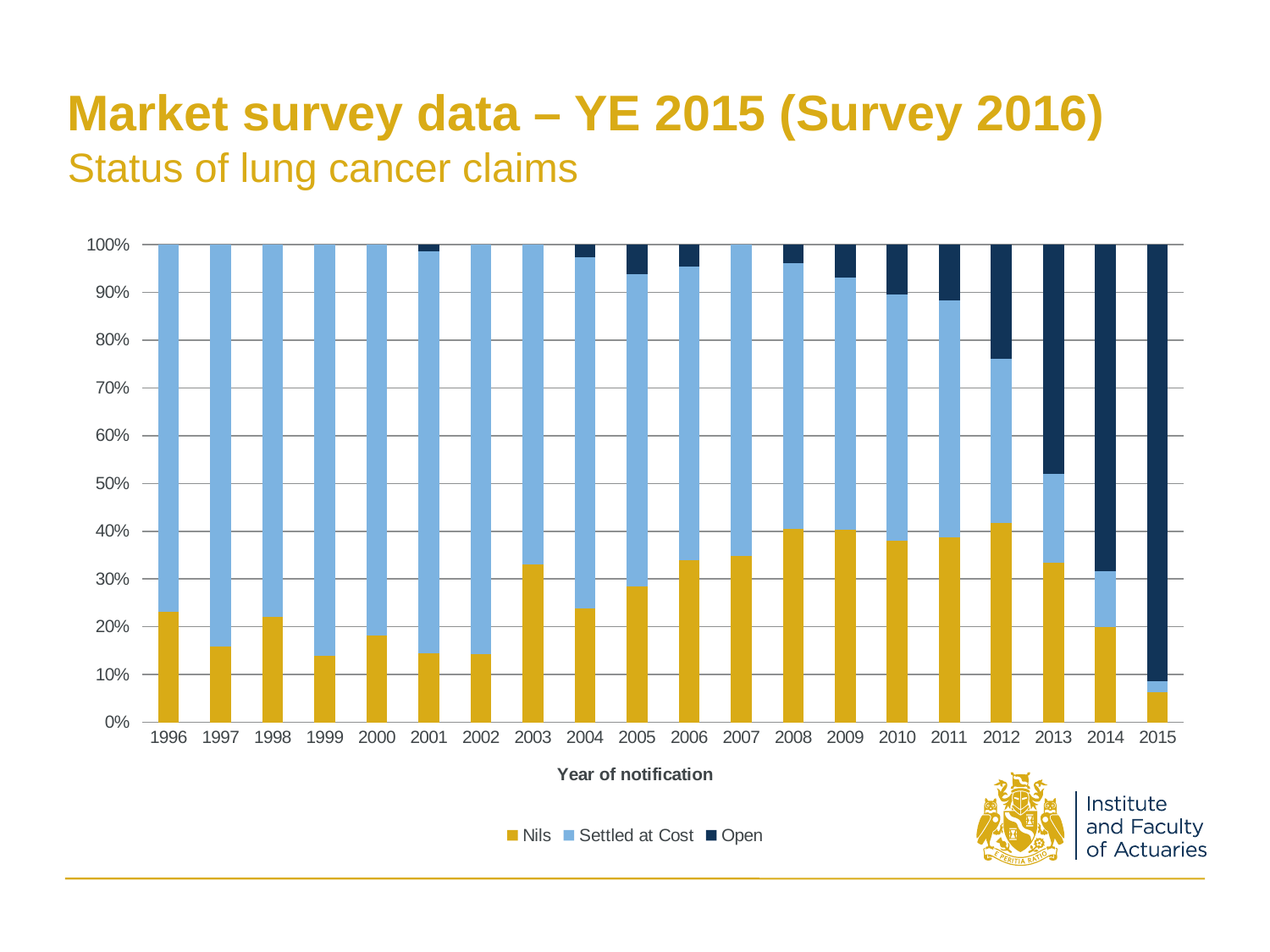
What is the title of the x axis? Year of notification What kind of chart is shown on the slide? Stacked bar chart How many series does the legend list? 3 Does the Open share generally rise or fall from 1996 to 2015? rise Which year has the larger Nils share, 1996 or 1997? 1996 Is the Open share for 2013 greater or less than 40%? greater How many years of notification are shown on the x axis? 20 Is the Nils share for 1999 greater or less than 20%? less What are the three series listed in the legend? Nils, Settled at Cost, Open Which year has the largest Open share? 2015 Is the Nils share for 2015 greater or less than 10%? less Which year has the smallest Nils share? 2015